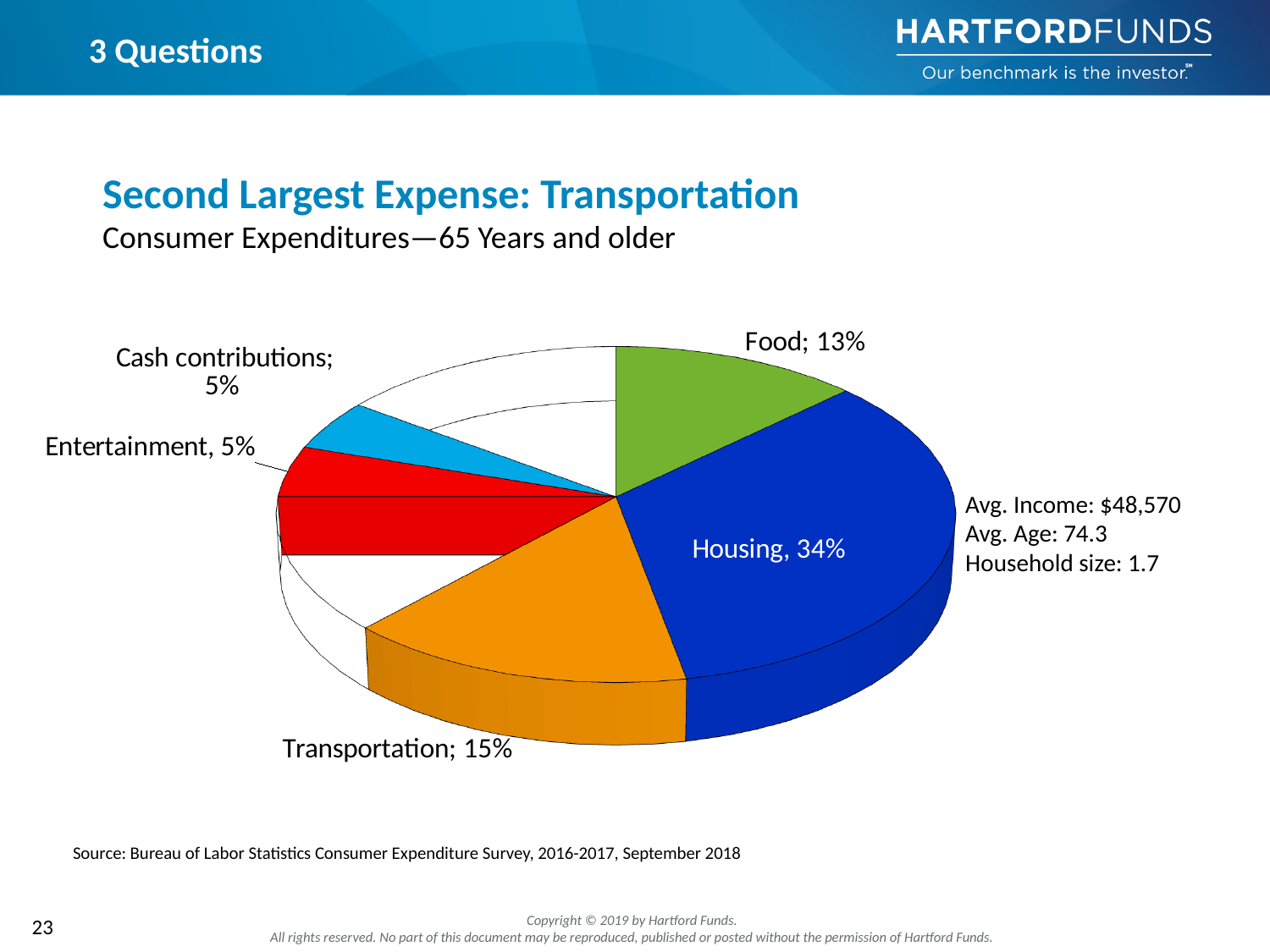
Which is larger, the share for Food or the share for Transportation? Transportation What age group does the chart's subtitle say the consumer expenditures are for? 65 Years and older What percentage does the Food slice represent? 13% What type of chart is shown on the slide? Pie chart What colour is the Housing slice of the pie? Blue What percentage is shown for Cash contributions? 5% What percentage is shown for Entertainment? 5% What share of the pie is Transportation? 15% Which labeled expense category has the largest share of the pie? Housing How many percentage points larger is Housing's share than Transportation's share? 19 percentage points What is the difference in percentage points between Transportation and Food? 2 percentage points What percentage of consumer expenditures for those 65 years and older goes to Housing? 34%